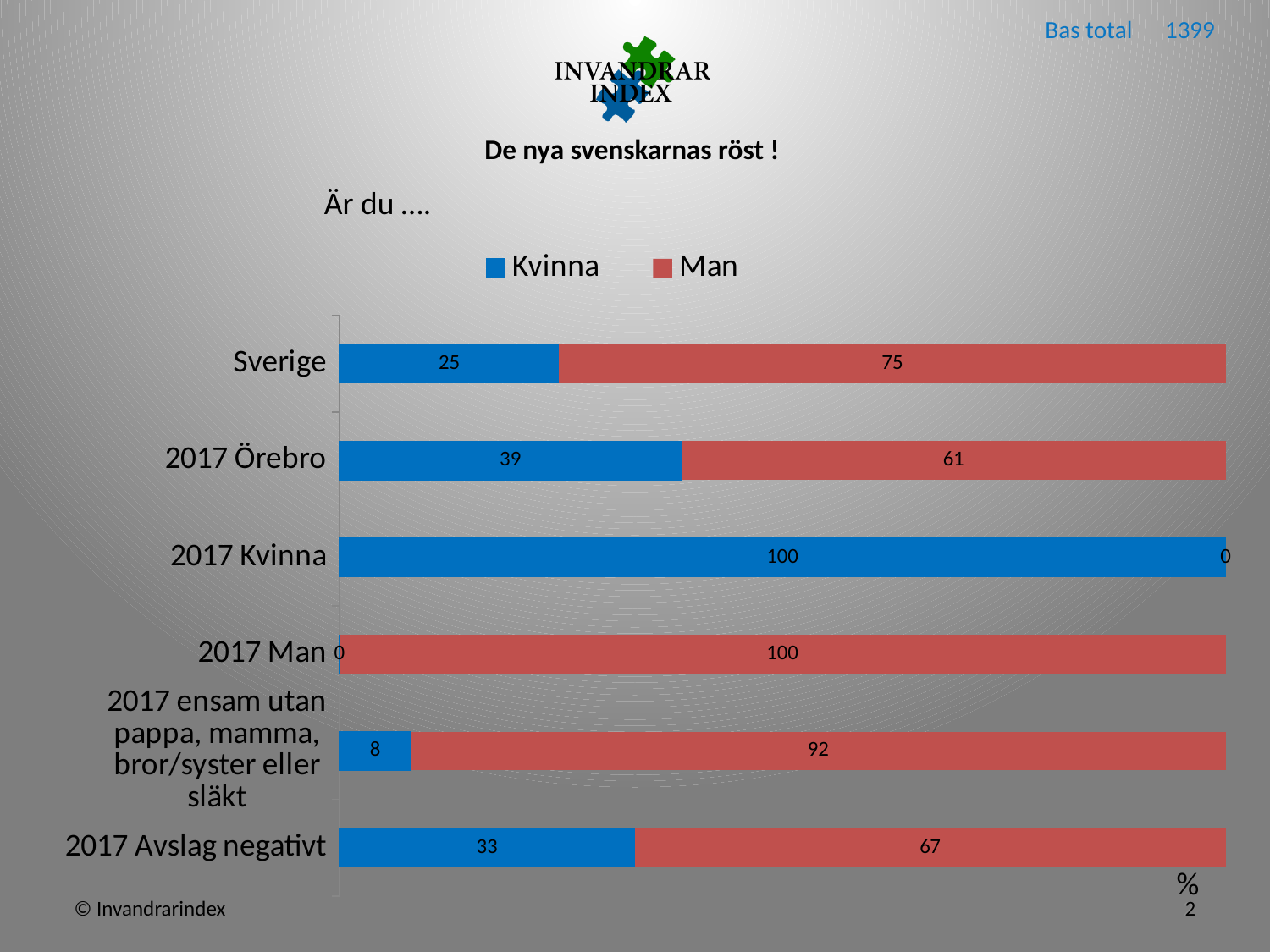
What is the Kvinna value for 2017 Avslag negativt? 33 How many series does the legend list? 2 Which category has the highest Kvinna value? 2017 Kvinna What is the Man value for 2017 Örebro? 61 Which category has the lowest Man value? 2017 Kvinna What kind of chart is shown? Stacked bar chart What is the difference between the Man and Kvinna values for Sverige? 50 Is the Kvinna value larger for 2017 Örebro or for 2017 Avslag negativt? 2017 Örebro How many categories are shown on the chart? 6 What is the Man value for 2017 ensam utan pappa, mamma, bror/syster eller släkt? 92 What is the total of the stacked bar for 2017 Örebro? 100 What is the Kvinna value for Sverige? 25